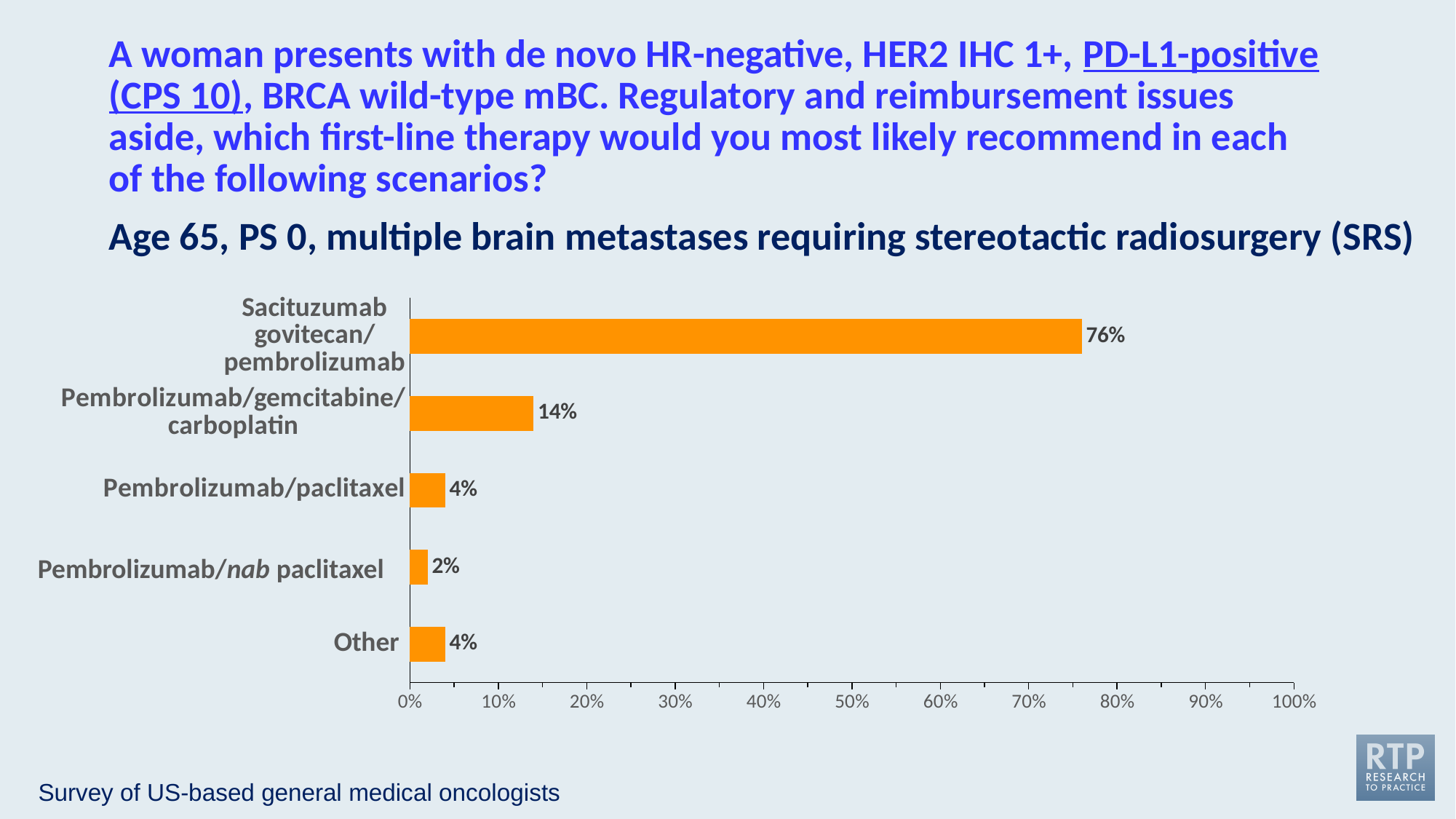
What is the maximum value shown on the x axis of the chart? 100% What percentage of respondents chose pembrolizumab/gemcitabine/carboplatin? 14% How many therapy options are shown in the chart? 5 Which therapy option received the lowest percentage of responses? Pembrolizumab/nab paclitaxel What percentage of respondents chose pembrolizumab/nab paclitaxel? 2% What percentage of respondents chose Other? 4% What is the difference in percentage points between sacituzumab govitecan/pembrolizumab and pembrolizumab/gemcitabine/carboplatin? 62 percentage points Is the value for sacituzumab govitecan/pembrolizumab greater or less than 70%? greater What percentage of respondents chose sacituzumab govitecan/pembrolizumab? 76% Which received a larger share of responses: pembrolizumab/paclitaxel or pembrolizumab/nab paclitaxel? Pembrolizumab/paclitaxel What type of chart is shown on the slide? Bar chart Which therapy option received the highest percentage of responses? Sacituzumab govitecan/pembrolizumab